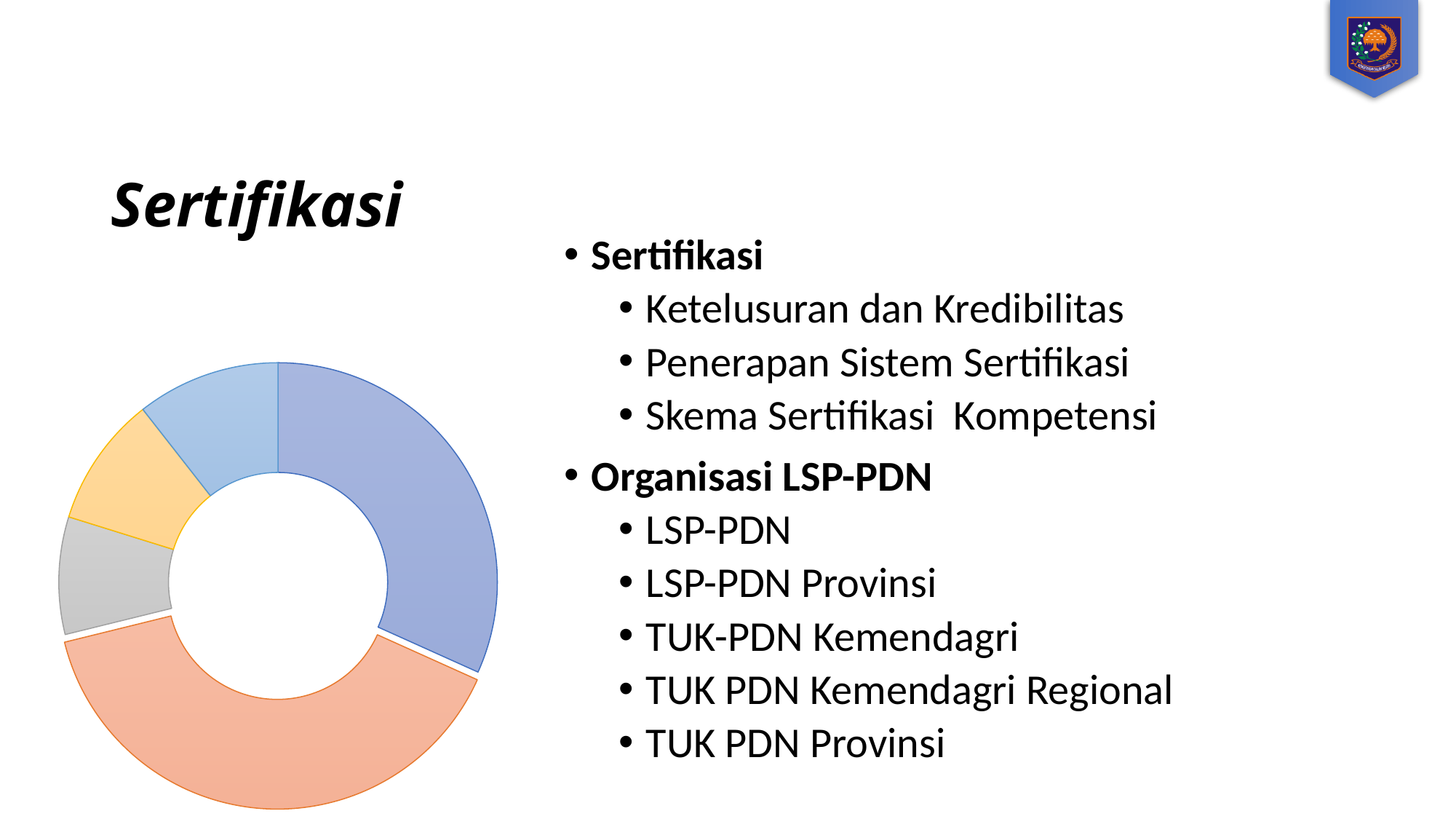
How many slices does the doughnut chart have? 5 Which slice of the doughnut chart is the largest? the orange slice Which is larger in the doughnut chart, the orange slice or the blue slice? the orange slice Which is larger in the doughnut chart, the blue slice or the gray slice? the blue slice What kind of chart is shown on the slide? doughnut chart Which is larger in the doughnut chart, the orange slice or the yellow slice? the orange slice Does the doughnut chart show data labels on its slices? No Does the doughnut chart display a legend? No